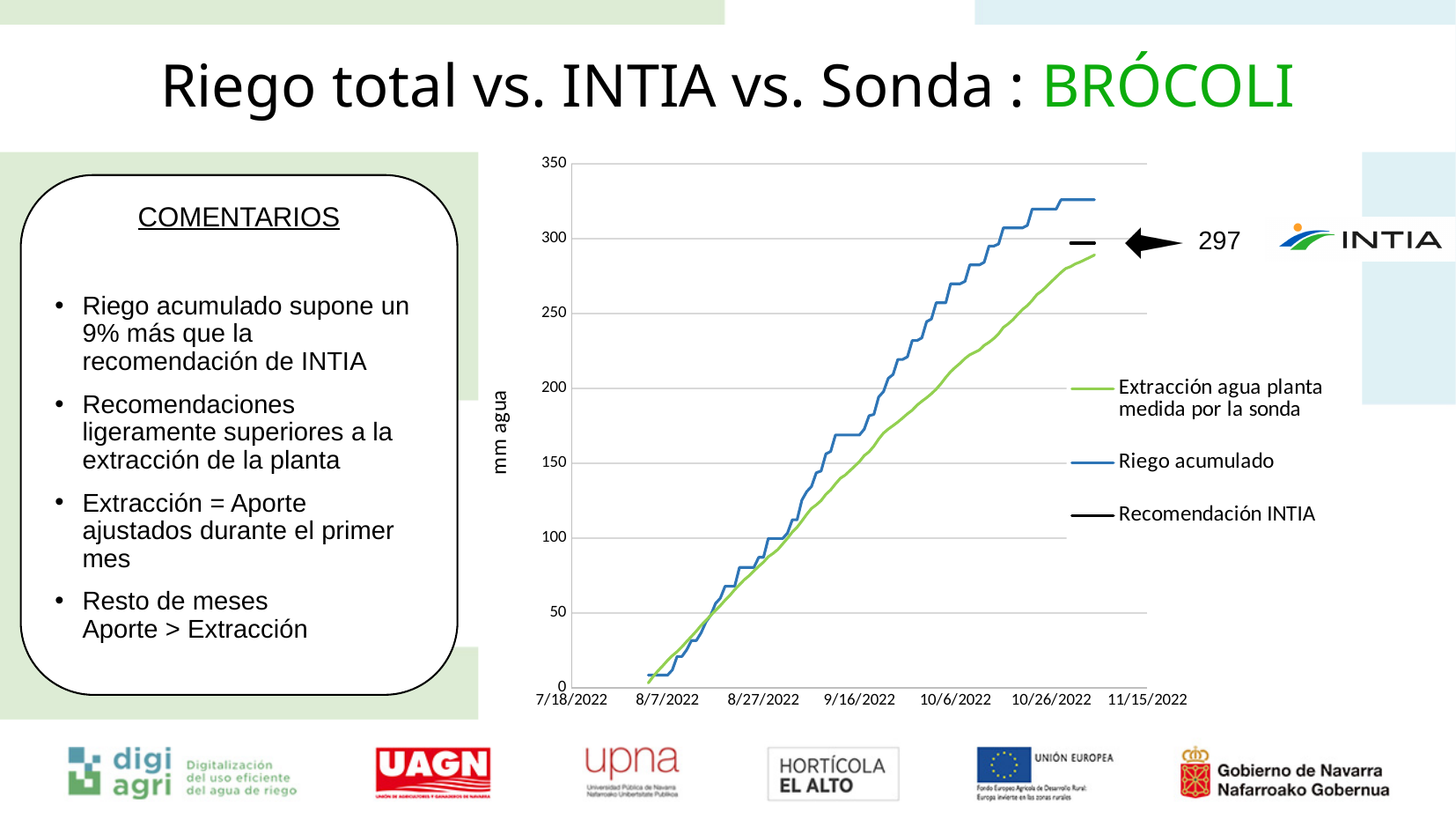
What is the label of the y axis? mm agua What value is labelled for Recomendación INTIA on the chart? 297 Do the values of Riego acumulado rise or fall along the x axis? rise Is the final value of Extracción agua planta medida por la sonda greater or less than 250? greater Is the final value of Riego acumulado greater or less than 300? greater Is the value of Riego acumulado at 10/26/2022 greater or less than 300? greater Which series reaches the highest value on the chart? Riego acumulado What kind of chart is shown on the slide? line chart What colour is the Riego acumulado line? blue At the end of the period, which series is higher: Riego acumulado or Extracción agua planta medida por la sonda? Riego acumulado How many series does the chart legend list? 3